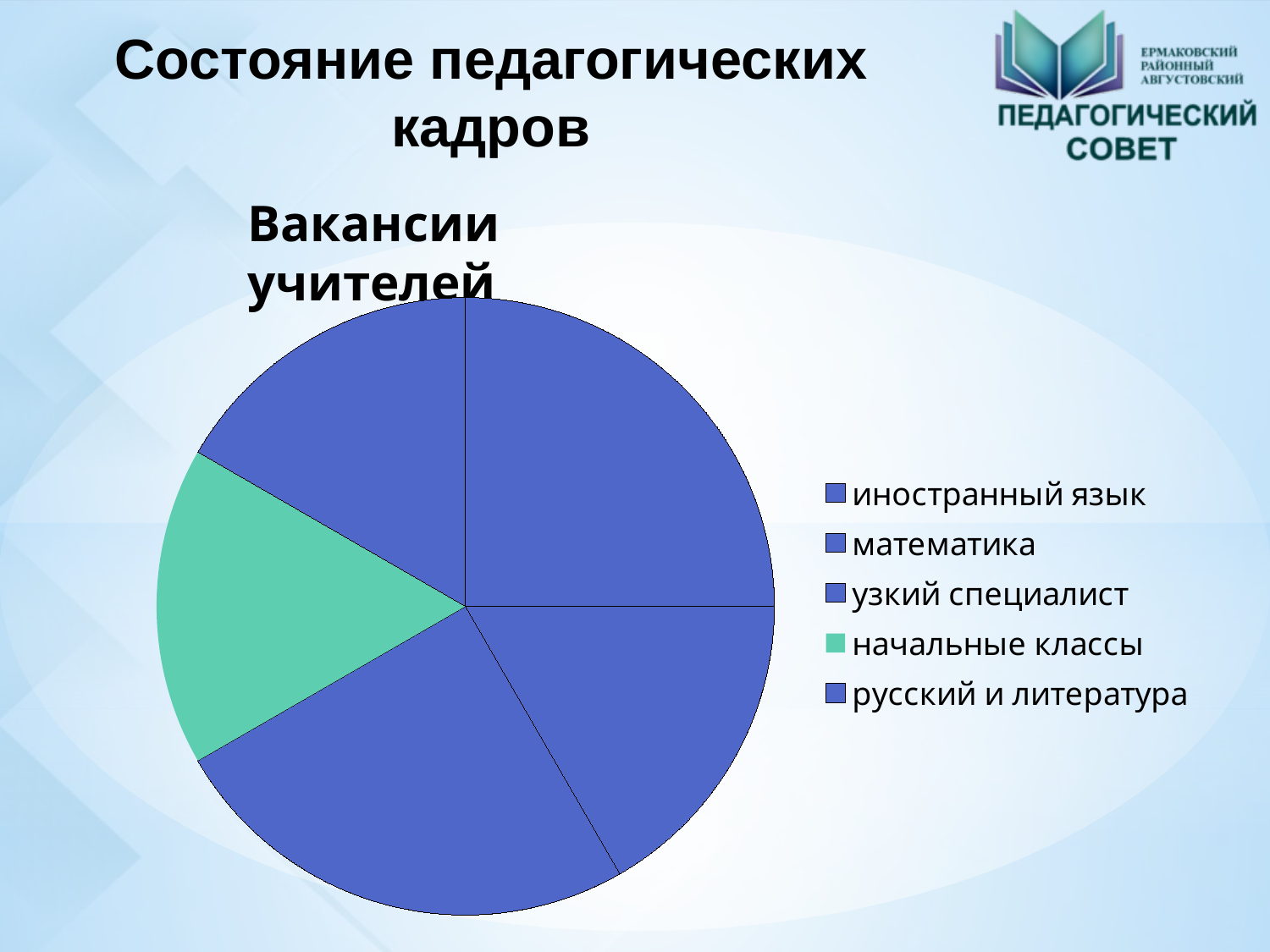
Which category is shown in green in the pie chart? начальные классы Which slice is larger: иностранный язык or начальные классы? иностранный язык Which slice is larger: узкий специалист or математика? узкий специалист What kind of chart is shown on the slide? pie chart How many categories does the legend of the pie chart list? 5 Which slice is larger: узкий специалист or начальные классы? узкий специалист How many slices does the pie chart have? 5 What is the title of the chart? Вакансии учителей